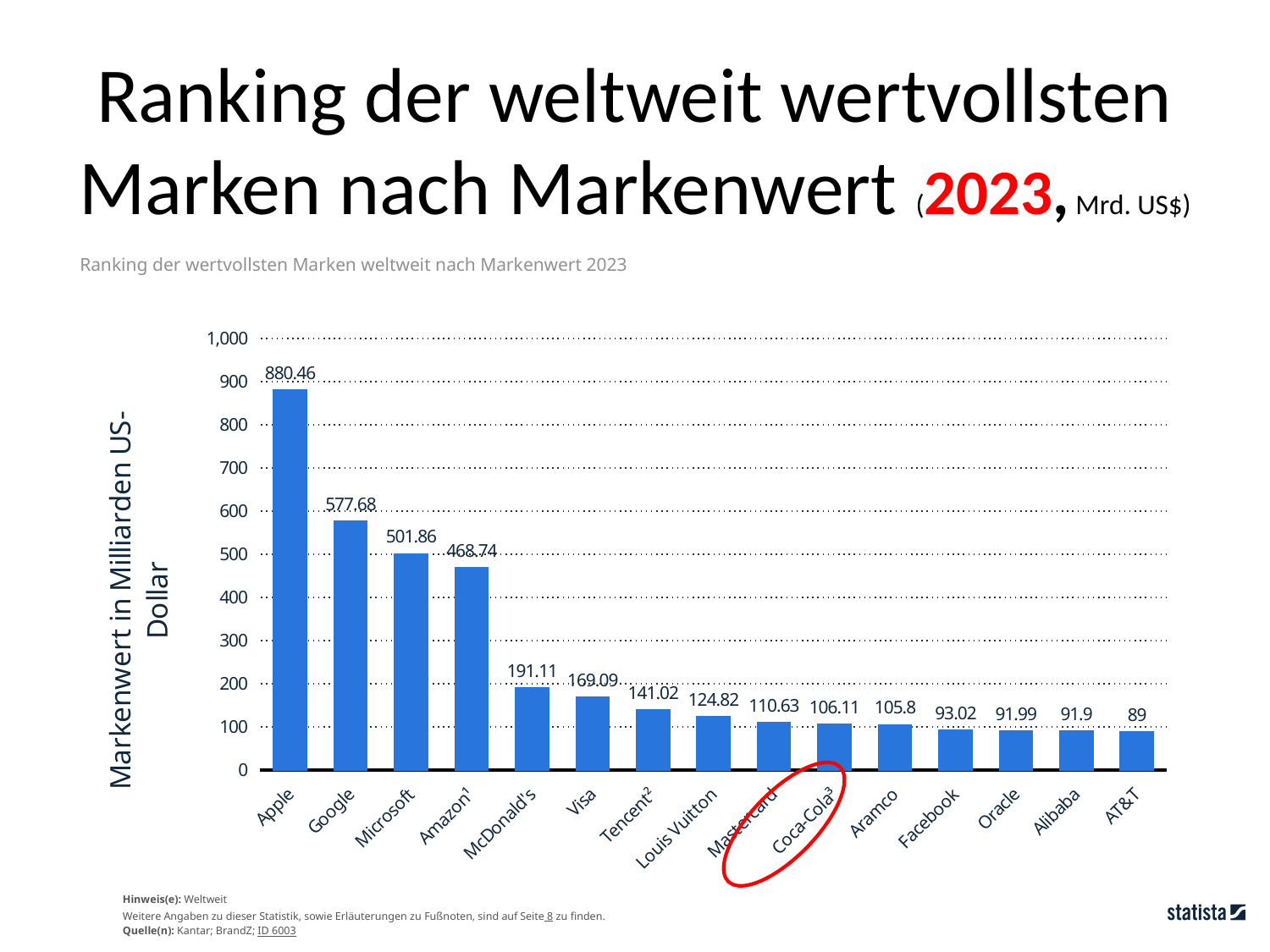
How many brands are shown in the chart? 15 Which has a higher brand value, Amazon or McDonald's? Amazon Is the value for Tencent greater or less than 200? less Which brand has the lowest brand value in the chart? AT&T What is the difference between the brand values of Google and Microsoft? 75.82 What is the brand value shown for Coca-Cola? 106.11 What is the brand value shown for Visa? 169.09 What kind of chart is shown on the slide? Bar chart Which brand has the highest brand value in the chart? Apple What is the label of the y axis? Markenwert in Milliarden US-Dollar What is the brand value shown for Apple? 880.46 Do the brand values rise or fall from left to right along the x axis? Fall